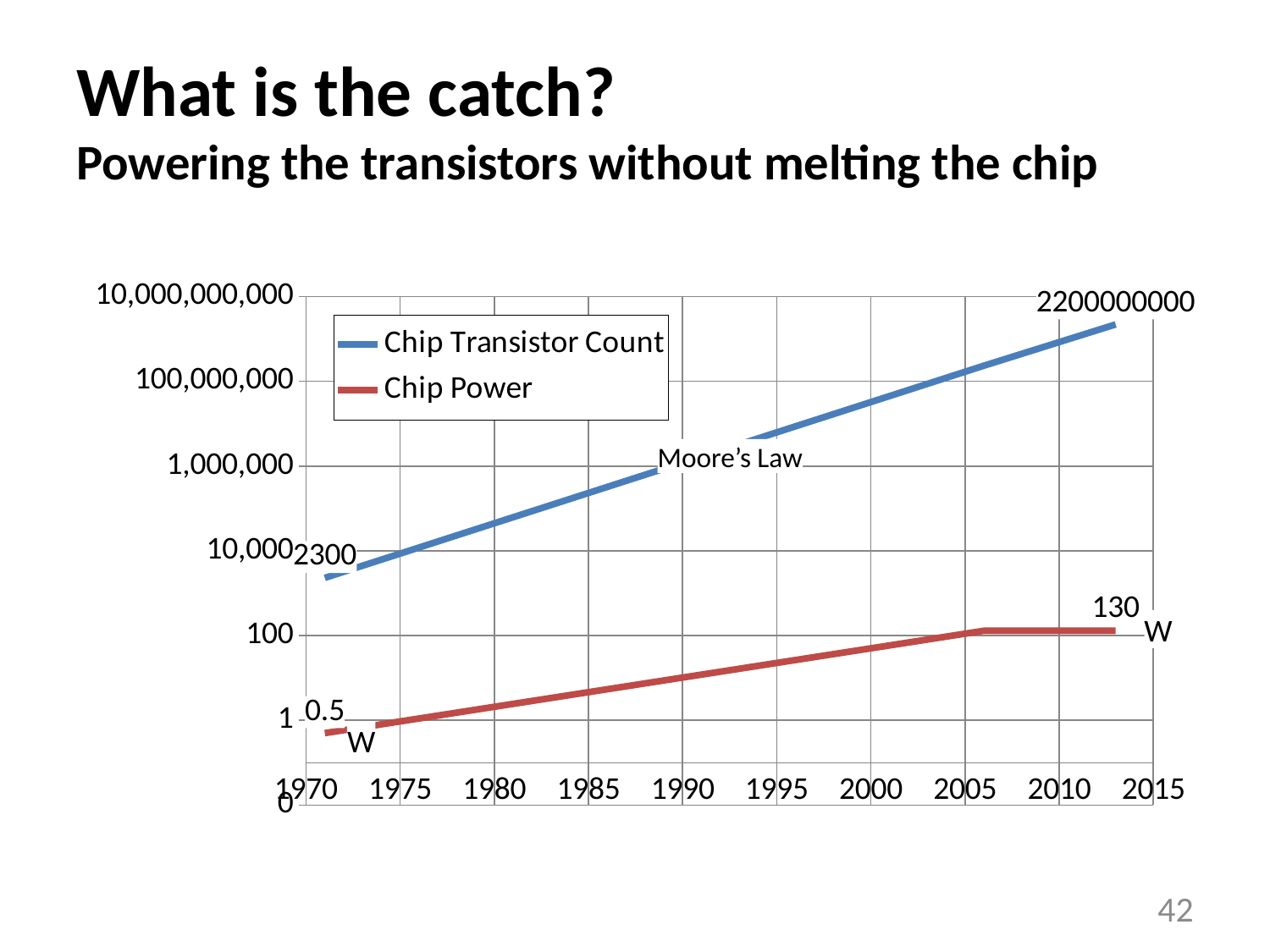
What are the two series named in the chart legend? Chip Transistor Count and Chip Power What text annotation is placed along the Chip Transistor Count line? Moore's Law By how much does the labelled Chip Power value increase from its first label to its last label? 129.5 W What is the first labelled value of the Chip Transistor Count series? 2300 Is the Chip Power value around 1990 greater or less than 100? less How many series does the chart legend list? 2 What is the last labelled value of the Chip Power series? 130 W Does the Chip Transistor Count series rise or fall from 1970 to 2015? rise What kind of chart is shown on the slide? line chart Around 2010, which series has the larger value, Chip Transistor Count or Chip Power? Chip Transistor Count What is the first labelled value of the Chip Power series? 0.5 W What is the last labelled value of the Chip Transistor Count series? 2200000000